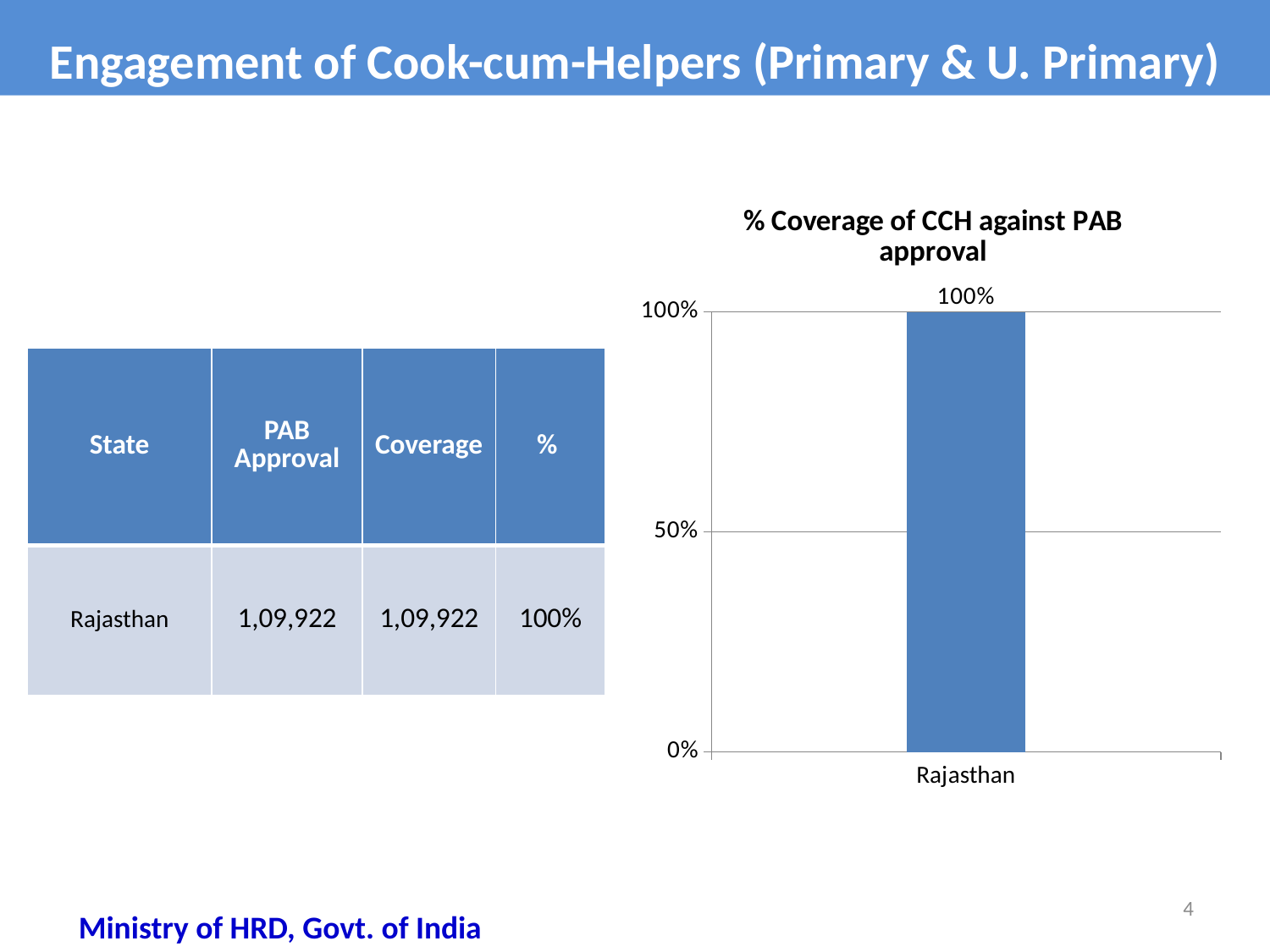
What is the value for Rajasthan in the chart? 100% Which state is shown on the x axis of the chart? Rajasthan What is the title of the chart? % Coverage of CCH against PAB approval What kind of chart is shown on the slide? bar chart How many categories are plotted in the chart? 1 What is the highest value shown on the y axis of the chart? 100% Is the value for Rajasthan greater or less than 50%? greater